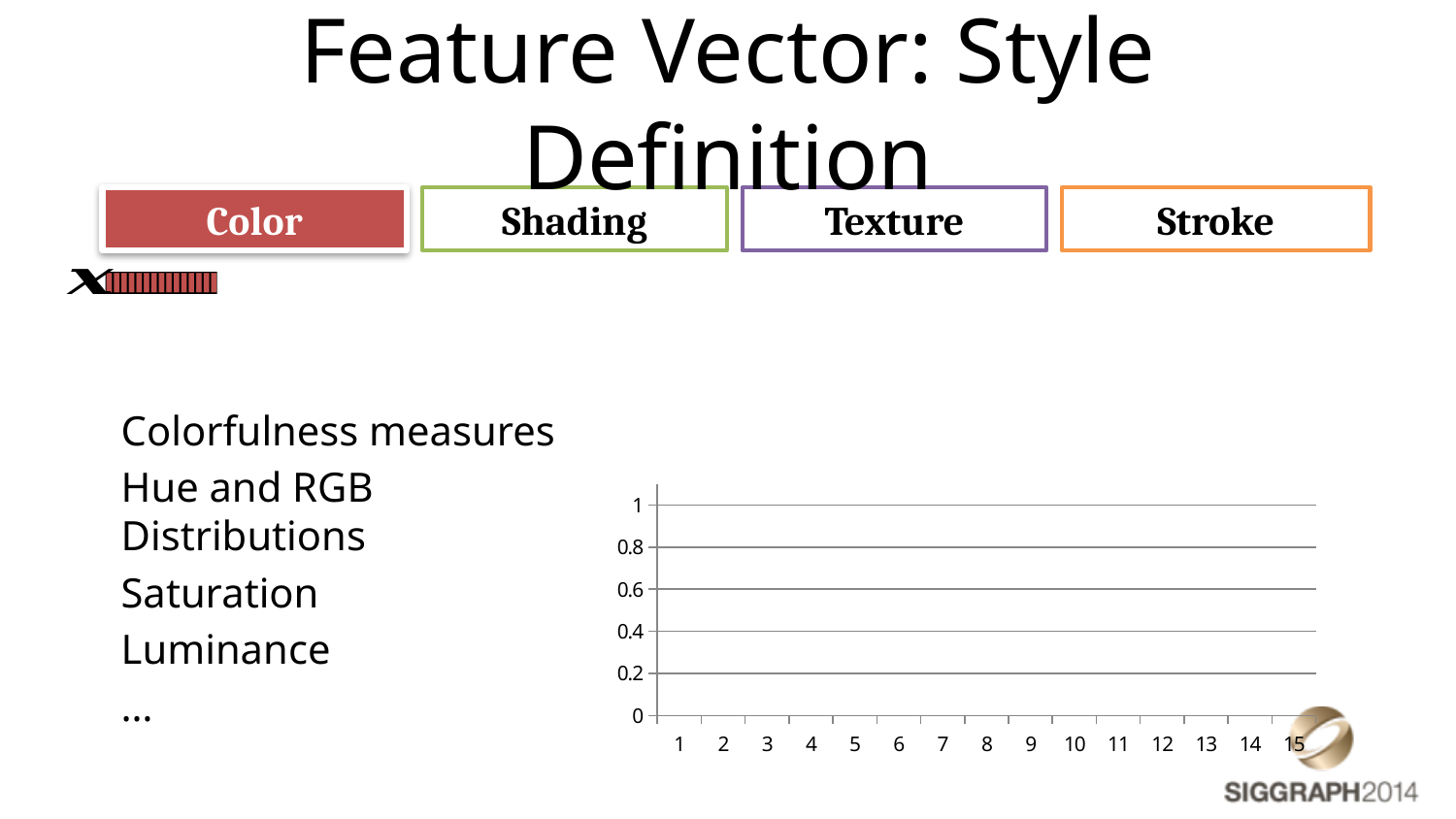
How many categories are labeled along the x axis of the chart? 15 What is the highest value shown on the chart's y axis? 1 What is the lowest value shown on the chart's y axis? 0 What is the label of the last category on the chart's x axis? 15 What is the label of the first category on the chart's x axis? 1